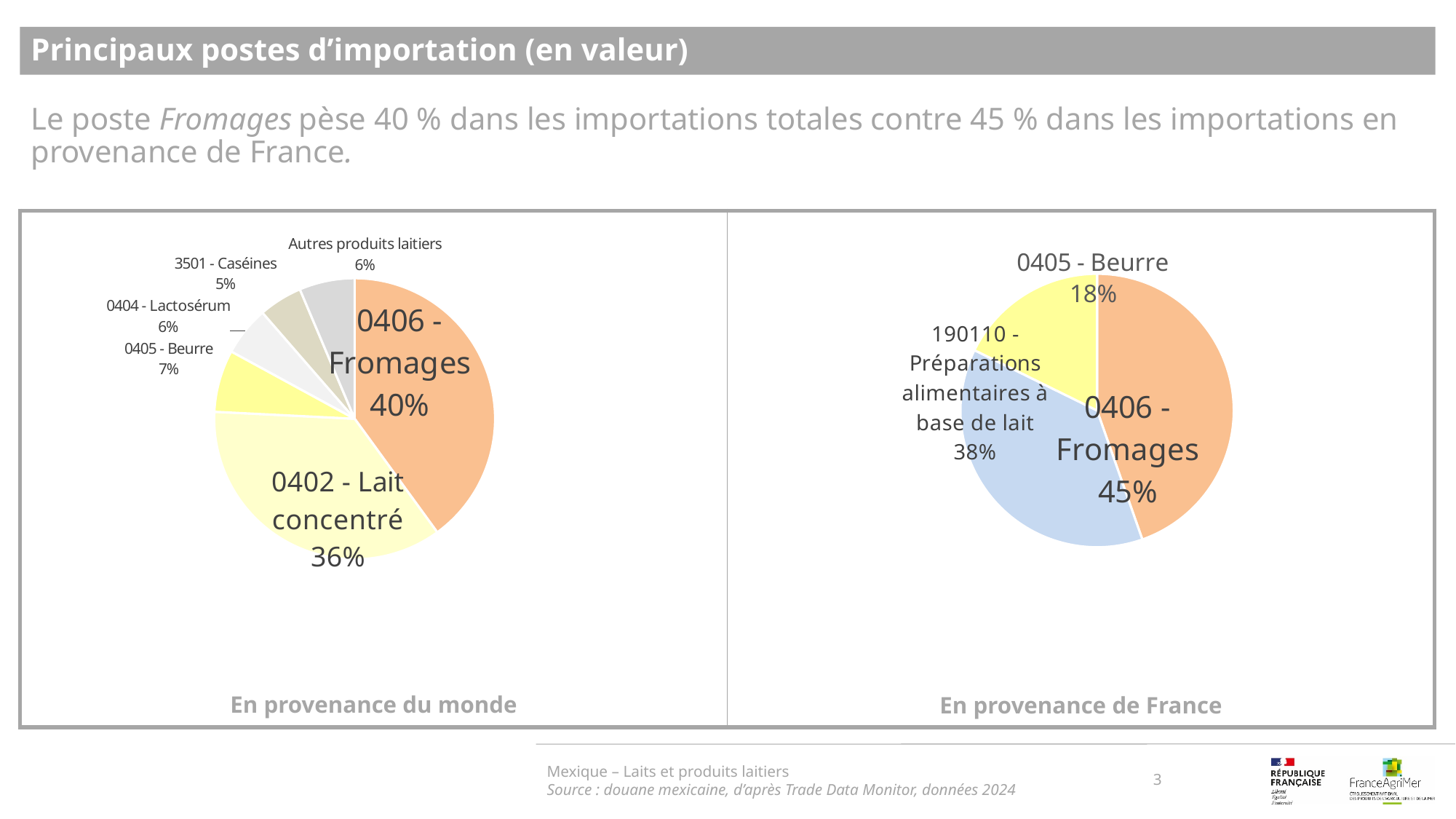
In the 'En provenance du monde' chart, which category has the smallest share? 3501 - Caséines In the 'En provenance de France' chart, which category has the largest share? 0406 - Fromages In the 'En provenance du monde' chart, what is the share of 3501 - Caséines? 5% In the 'En provenance du monde' chart, what share does 0402 - Lait concentré represent? 36% In the 'En provenance du monde' chart, how many slices does the pie have? 6 In the 'En provenance du monde' chart, what share do 0406 - Fromages account for? 40% In the 'En provenance de France' chart, how many categories are shown? 3 Is the share of 0405 - Beurre larger in the 'En provenance du monde' chart or in the 'En provenance de France' chart? En provenance de France What type of chart is used on this slide? Pie chart In the 'En provenance du monde' chart, what is the difference between the shares of 0406 - Fromages and 0402 - Lait concentré? 4 percentage points In the 'En provenance de France' chart, what is the share of 0405 - Beurre? 18% In the 'En provenance de France' chart, what share does 190110 - Préparations alimentaires à base de lait represent? 38%